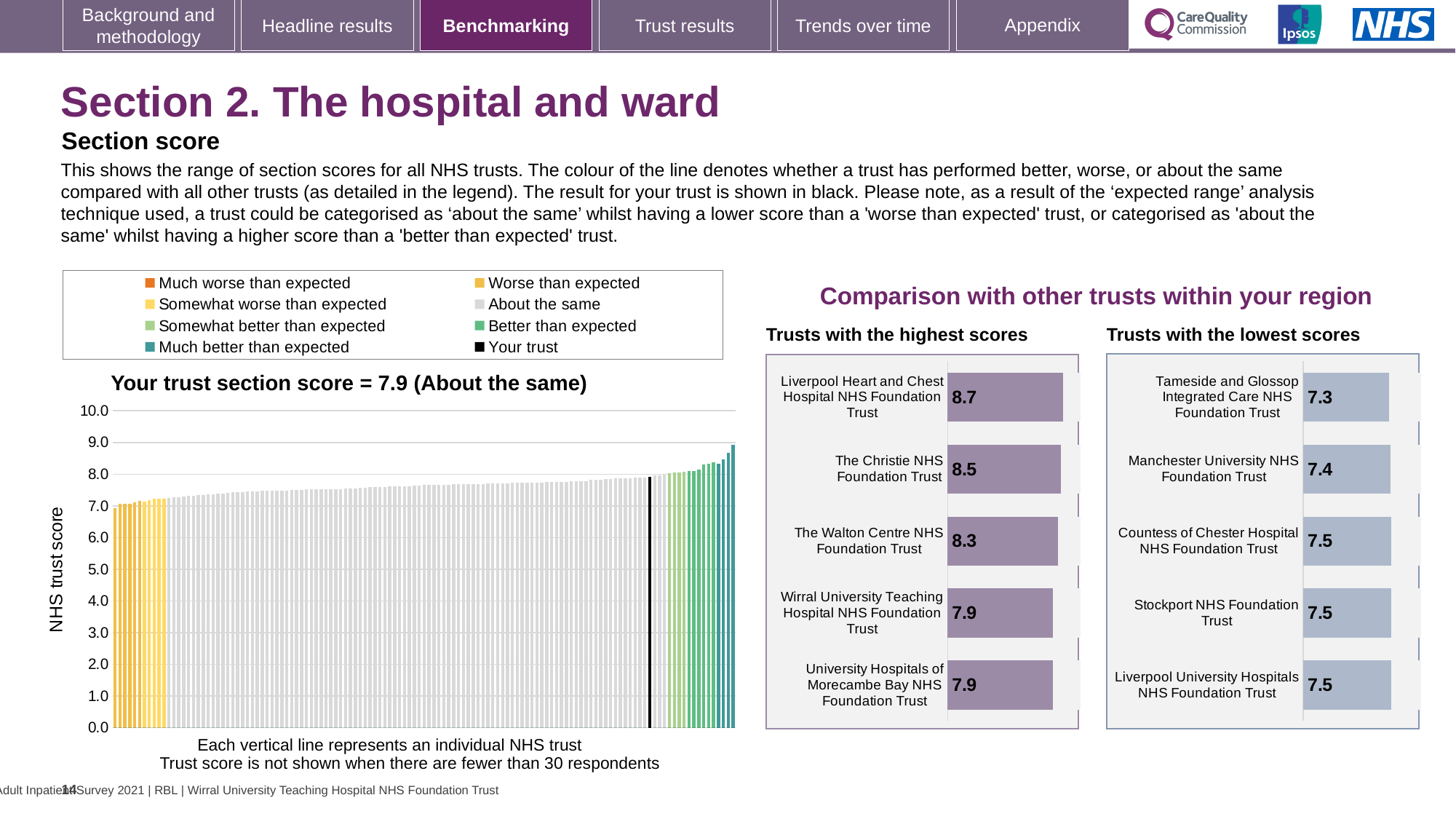
In the 'Trusts with the highest scores' chart, which has the larger score: The Christie NHS Foundation Trust or The Walton Centre NHS Foundation Trust? The Christie NHS Foundation Trust In the 'Trusts with the lowest scores' chart, what is the difference between the scores of Stockport NHS Foundation Trust and Tameside and Glossop Integrated Care NHS Foundation Trust? 0.2 In the 'Trusts with the highest scores' chart, what is the score for The Christie NHS Foundation Trust? 8.5 In the 'Trusts with the highest scores' chart, how many trusts are shown? 5 In the 'Trusts with the highest scores' chart, what is the score for The Walton Centre NHS Foundation Trust? 8.3 In the 'Trusts with the highest scores' chart, what is the difference between the scores of Liverpool Heart and Chest Hospital NHS Foundation Trust and Wirral University Teaching Hospital NHS Foundation Trust? 0.8 In the 'Trusts with the highest scores' chart, which trust has the highest score? Liverpool Heart and Chest Hospital NHS Foundation Trust What kind of chart is the 'Your trust section score' chart? Bar chart In the 'Your trust section score' chart, do the trust scores rise or fall from left to right? Rise In the 'Trusts with the lowest scores' chart, what is the score for Manchester University NHS Foundation Trust? 7.4 In the 'Trusts with the lowest scores' chart, which trust has the lowest score? Tameside and Glossop Integrated Care NHS Foundation Trust In the 'Your trust section score' chart, what is the section score for your trust? 7.9